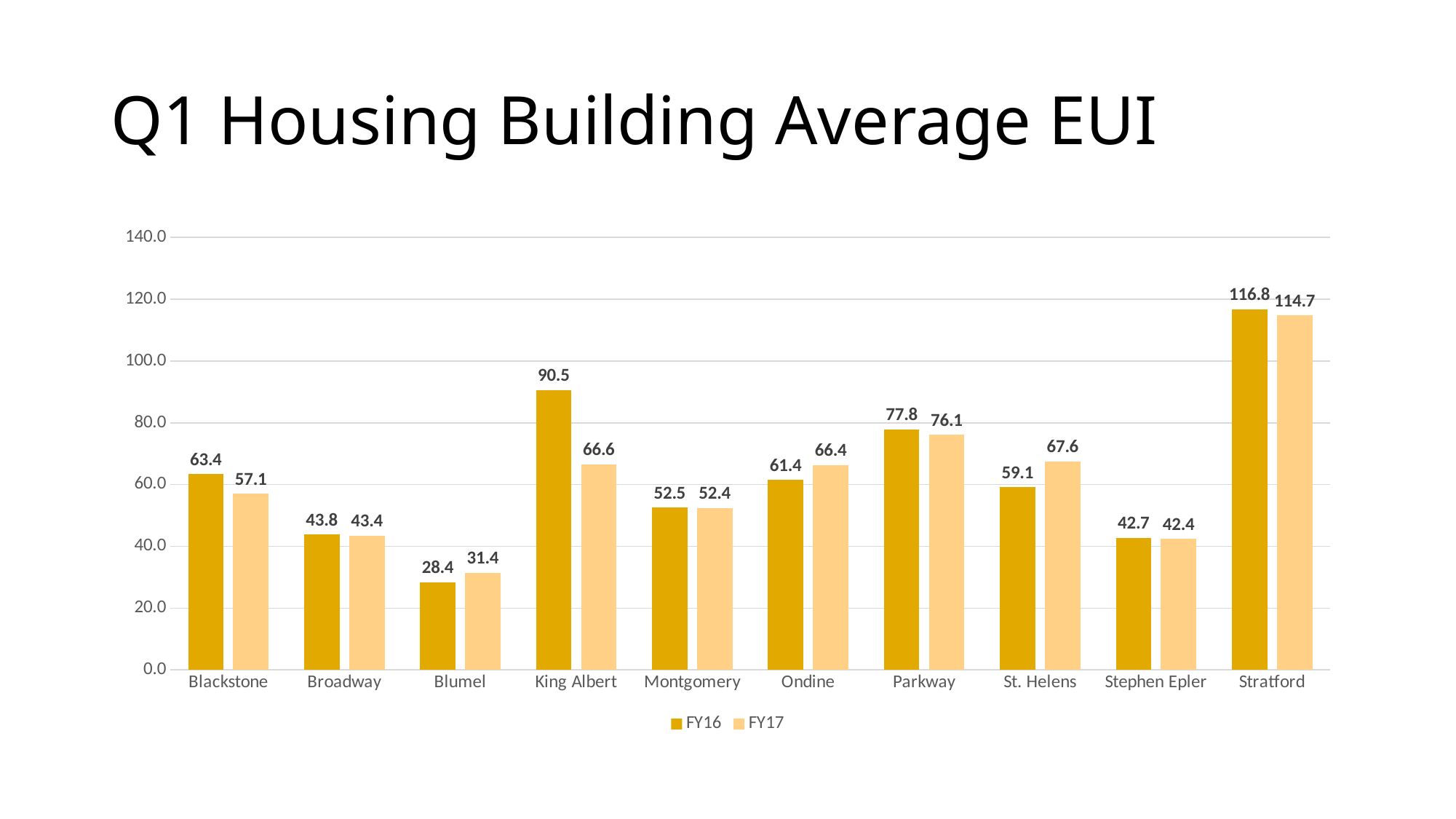
What is the FY17 value for St. Helens? 67.6 What is the FY17 value for Blumel? 31.4 What is the title of the chart? Q1 Housing Building Average EUI How many series does the legend list? 2 What kind of chart is shown on the slide? bar chart What is the FY16 value for King Albert? 90.5 Which building has the lowest FY17 value? Blumel What is the difference between the FY16 and FY17 values for King Albert? 23.9 Which building has the highest FY16 value? Stratford How many buildings are shown on the x axis? 10 Which is larger for Ondine, the FY16 value or the FY17 value? FY17 Is the FY16 value for Stratford greater or less than 100.0? greater